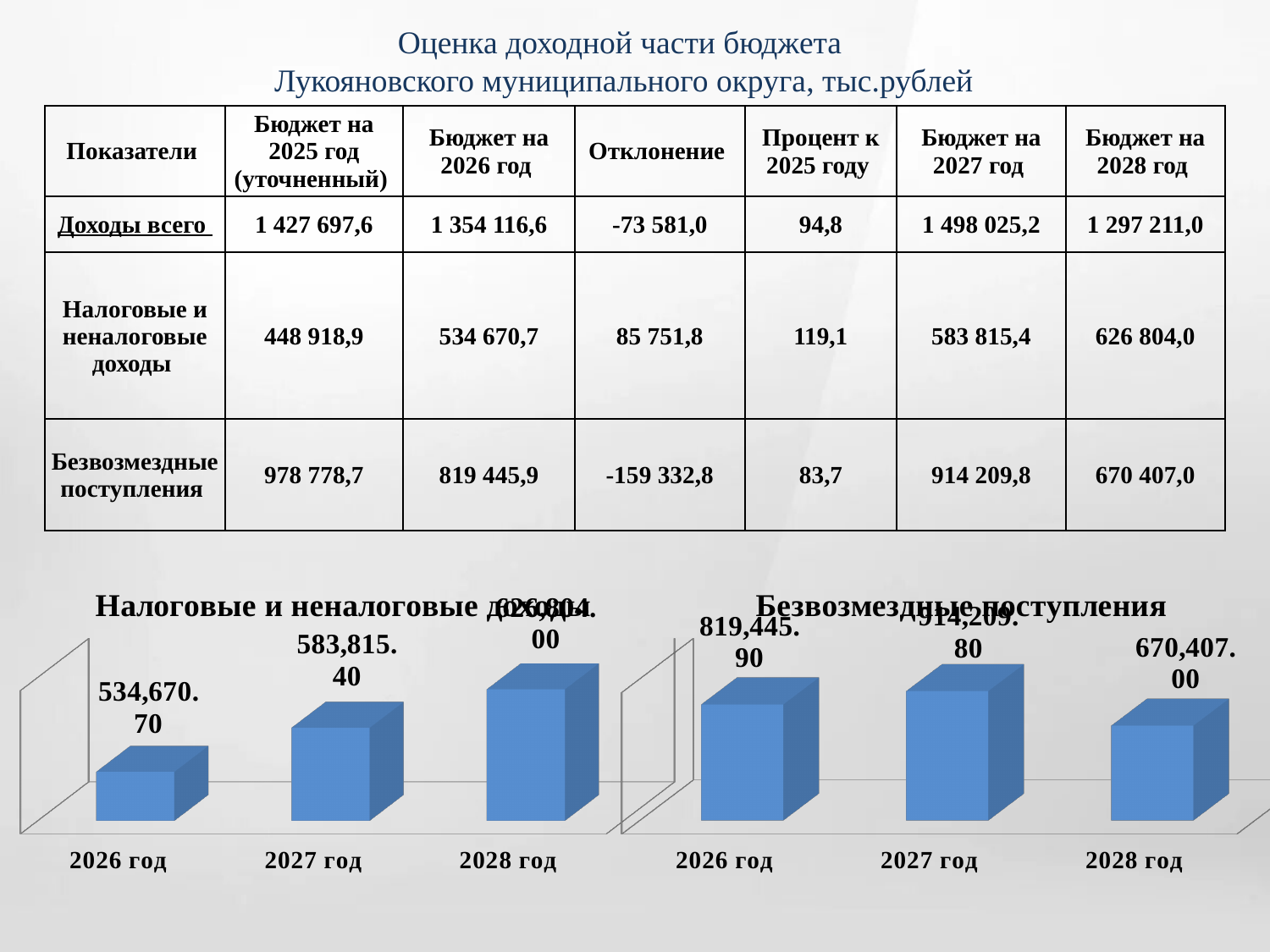
In the chart titled "Безвозмездные поступления", what is the value for 2026 год? 819,445.90 What kind of chart is the chart titled "Налоговые и неналоговые доходы"? bar chart In the chart titled "Налоговые и неналоговые доходы", what is the value for 2027 год? 583,815.40 How many years are shown on the x axis of the chart titled "Безвозмездные поступления"? 3 In the chart titled "Безвозмездные поступления", which year has the lowest value? 2028 год In the chart titled "Налоговые и неналоговые доходы", what is the value for 2026 год? 534,670.70 In the chart titled "Безвозмездные поступления", which year has the highest value? 2027 год In the chart titled "Налоговые и неналоговые доходы", which year has the lowest value? 2026 год In the chart titled "Безвозмездные поступления", what is the value for 2028 год? 670,407.00 In the chart titled "Налоговые и неналоговые доходы", which year has the highest value? 2028 год In the chart titled "Безвозмездные поступления", which is larger, the value for 2026 год or the value for 2028 год? 2026 год In the chart titled "Налоговые и неналоговые доходы", do the values rise or fall from 2026 год to 2028 год? rise